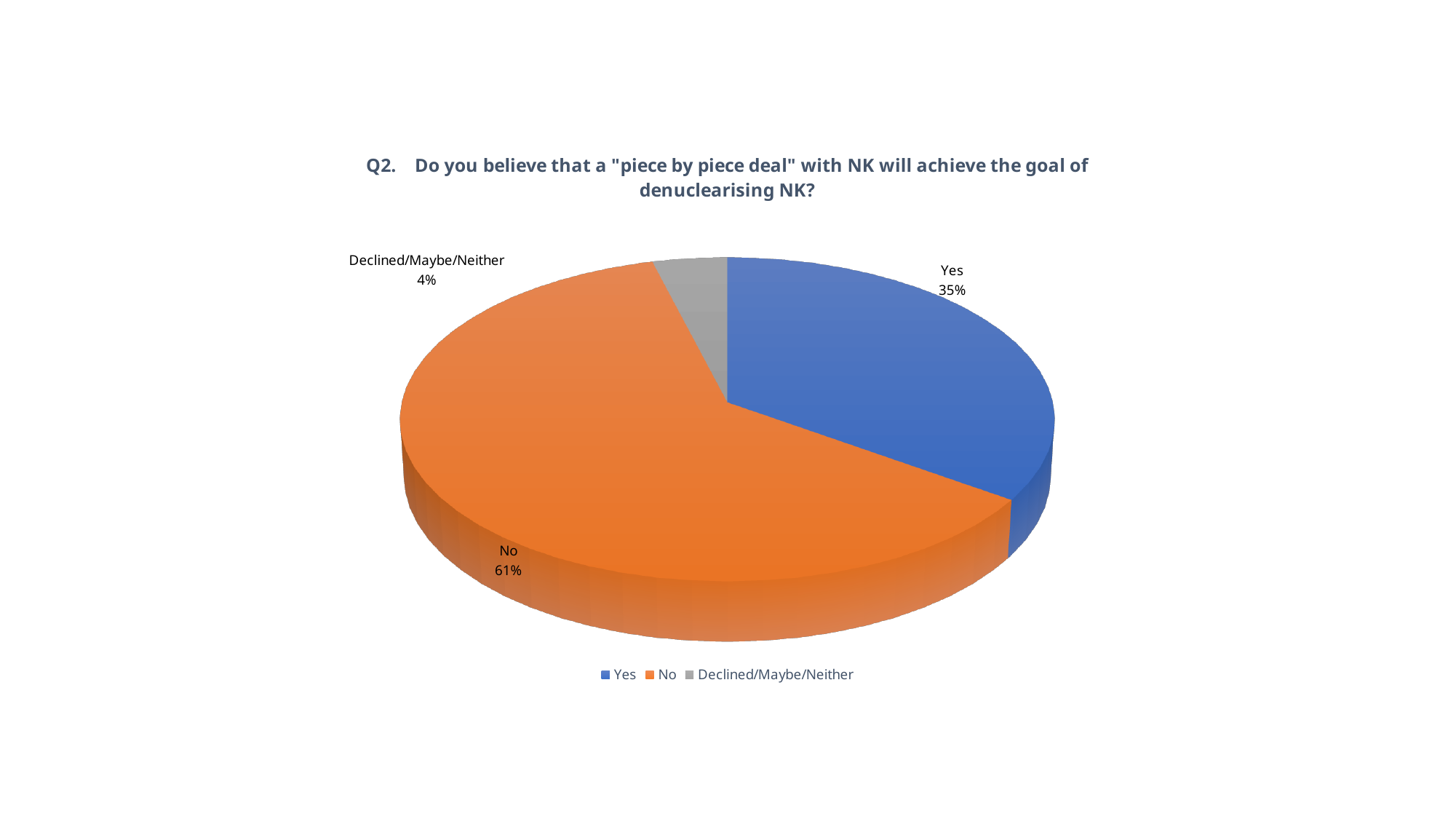
Which is larger, the share for "Yes" or the share for "Declined/Maybe/Neither"? Yes Which response has the largest share of the pie? No What is the difference in percentage points between "No" and "Yes"? 26 What is the title of the chart? Q2. Do you believe that a "piece by piece deal" with NK will achieve the goal of denuclearising NK? How many entries does the legend list? 3 What percentage of respondents answered "No"? 61% How many slices does the pie chart have? 3 Which response has the smallest share of the pie? Declined/Maybe/Neither What percentage of respondents answered "Yes"? 35% What kind of chart is shown on the slide? Pie chart What percentage is shown for "Declined/Maybe/Neither"? 4% What colour is the "No" slice? Orange